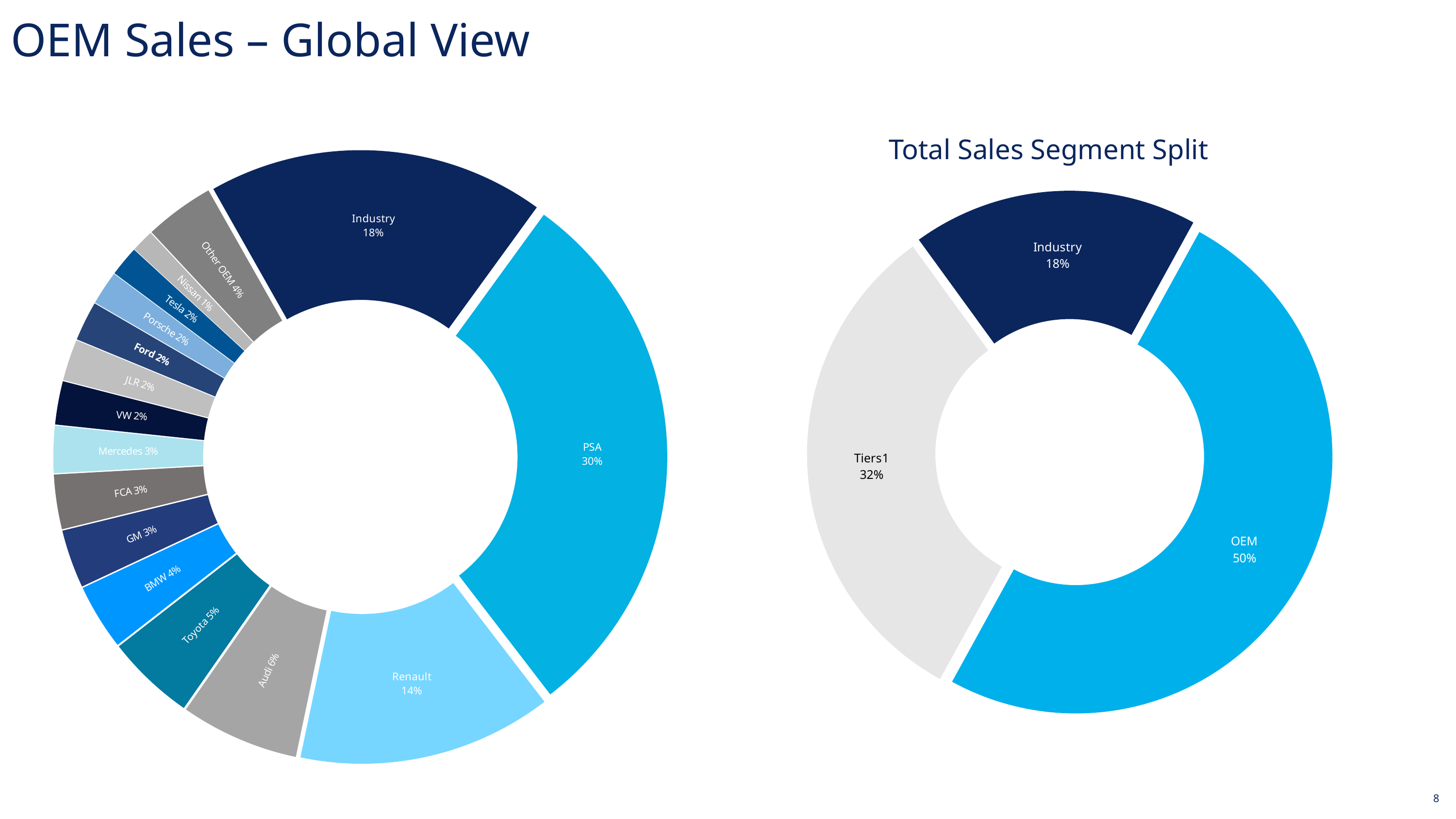
In the donut chart on the left, which is larger, Audi or Toyota? Audi In the 'Total Sales Segment Split' chart on the right, which segment has the smallest share? Industry In the 'Total Sales Segment Split' chart on the right, which segment has the largest share? OEM In the 'Total Sales Segment Split' chart on the right, what share does OEM have? 50% In the donut chart on the left, what share does Renault have? 14% What type of chart is the chart on the right? Donut (pie) chart In the donut chart on the left, what is the difference between the PSA share and the Renault share? 16% In the donut chart on the left, what share does PSA have? 30% In the donut chart on the left, which slice is the largest? PSA In the 'Total Sales Segment Split' chart on the right, how many segments are shown? 3 In the 'Total Sales Segment Split' chart on the right, what is the difference between the OEM share and the Tiers1 share? 18% In the 'Total Sales Segment Split' chart on the right, what share does Tiers1 have? 32%